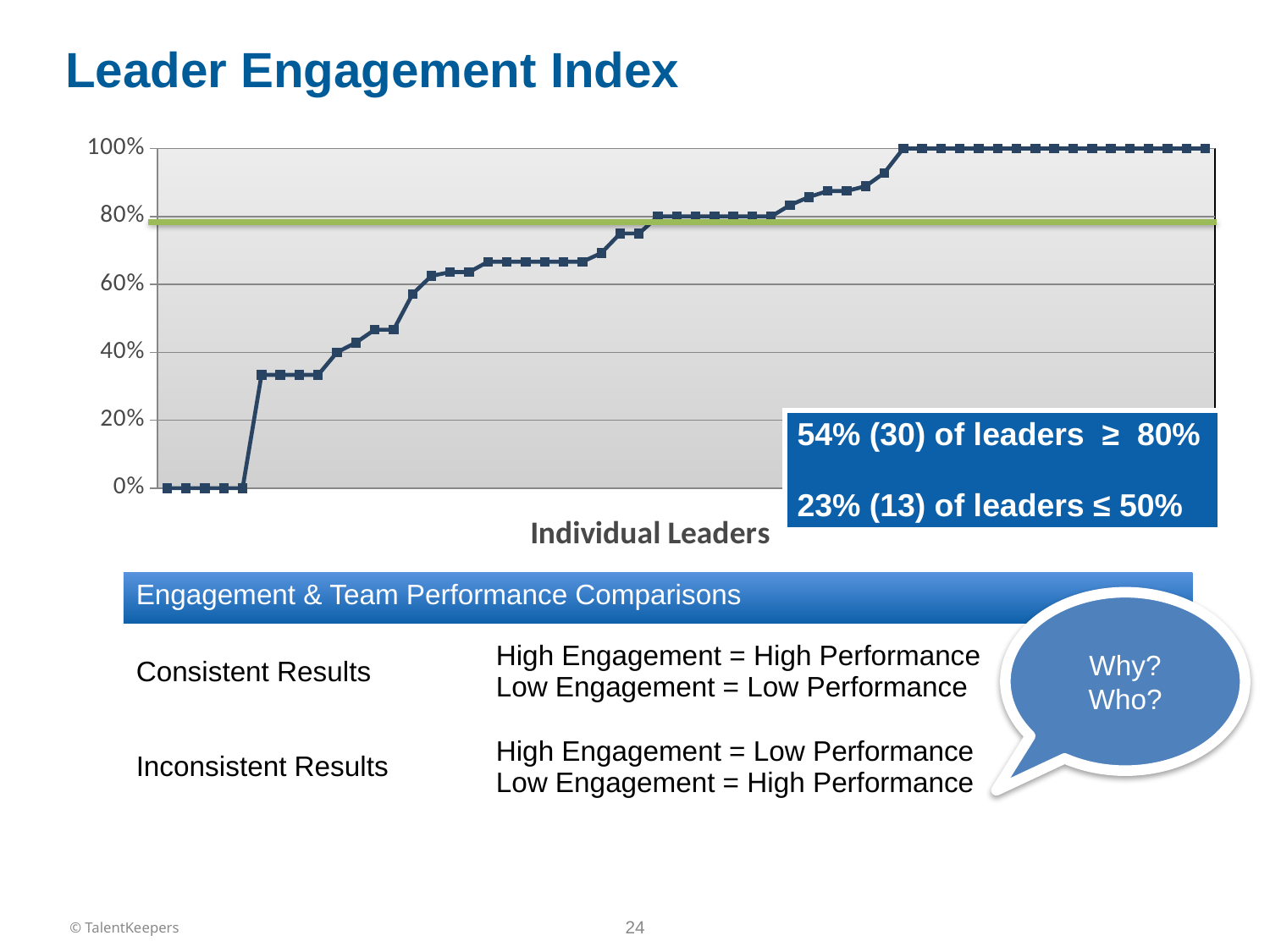
Which is larger, the value of the leftmost point or the value of the rightmost point on the line? the rightmost point Do the values on the Leader Engagement Index chart rise or fall from left to right along the x axis? rise What kind of chart is shown on the slide? line chart Is the value of the rightmost point on the line greater or less than 80%? greater Is the value of the leftmost point on the line greater or less than 20%? less What is the title of the x axis on the chart? Individual Leaders What value do the first points on the left of the line sit at? 0% What is the highest value shown on the y axis of the chart? 100% Is the value of the point at the middle of the line (around the green horizontal line) greater or less than 40%? greater What value do the points at the far right of the line sit at? 100%